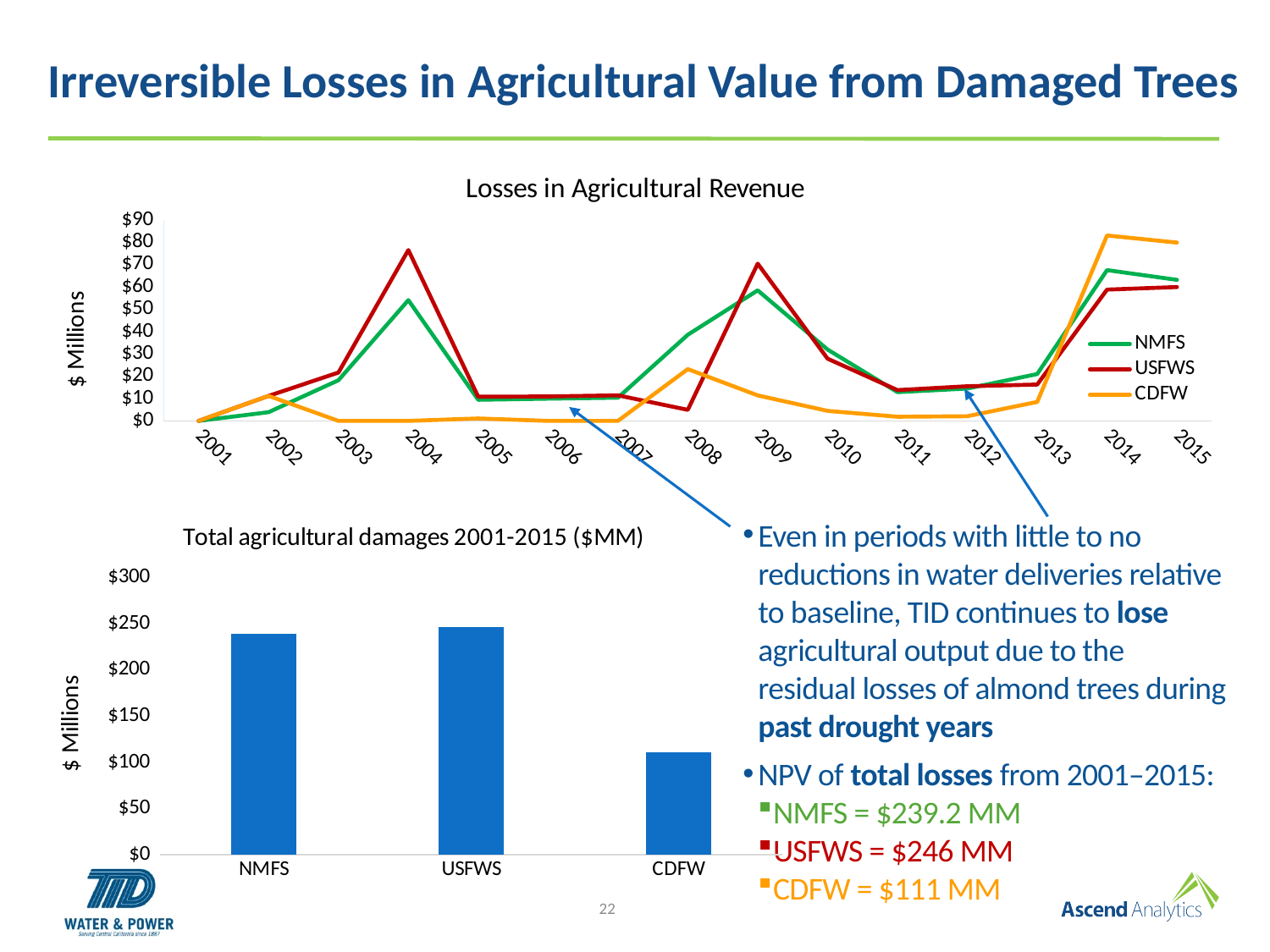
In the 'Losses in Agricultural Revenue' chart, which colour is used for the CDFW series? orange What kind of chart is the 'Losses in Agricultural Revenue' chart? line chart How many years are shown on the x axis of the 'Losses in Agricultural Revenue' chart? 15 In the 'Losses in Agricultural Revenue' chart, in which year does the CDFW series reach its highest value? 2014 In the 'Losses in Agricultural Revenue' chart, which series has the larger value in 2014, CDFW or USFWS? CDFW In the 'Losses in Agricultural Revenue' chart, is the USFWS value for 2004 greater or less than $70? greater In the 'Losses in Agricultural Revenue' chart, in which year does the USFWS series reach its highest value? 2004 What kind of chart is the 'Total agricultural damages 2001-2015 ($MM)' chart? bar chart In the 'Losses in Agricultural Revenue' chart, which series has the larger value in 2008, NMFS or USFWS? NMFS In the 'Losses in Agricultural Revenue' chart, is the NMFS value for 2004 greater or less than $60? less How many series does the legend of the 'Losses in Agricultural Revenue' chart list? 3 In the 'Total agricultural damages 2001-2015 ($MM)' chart, which category has the lowest value? CDFW